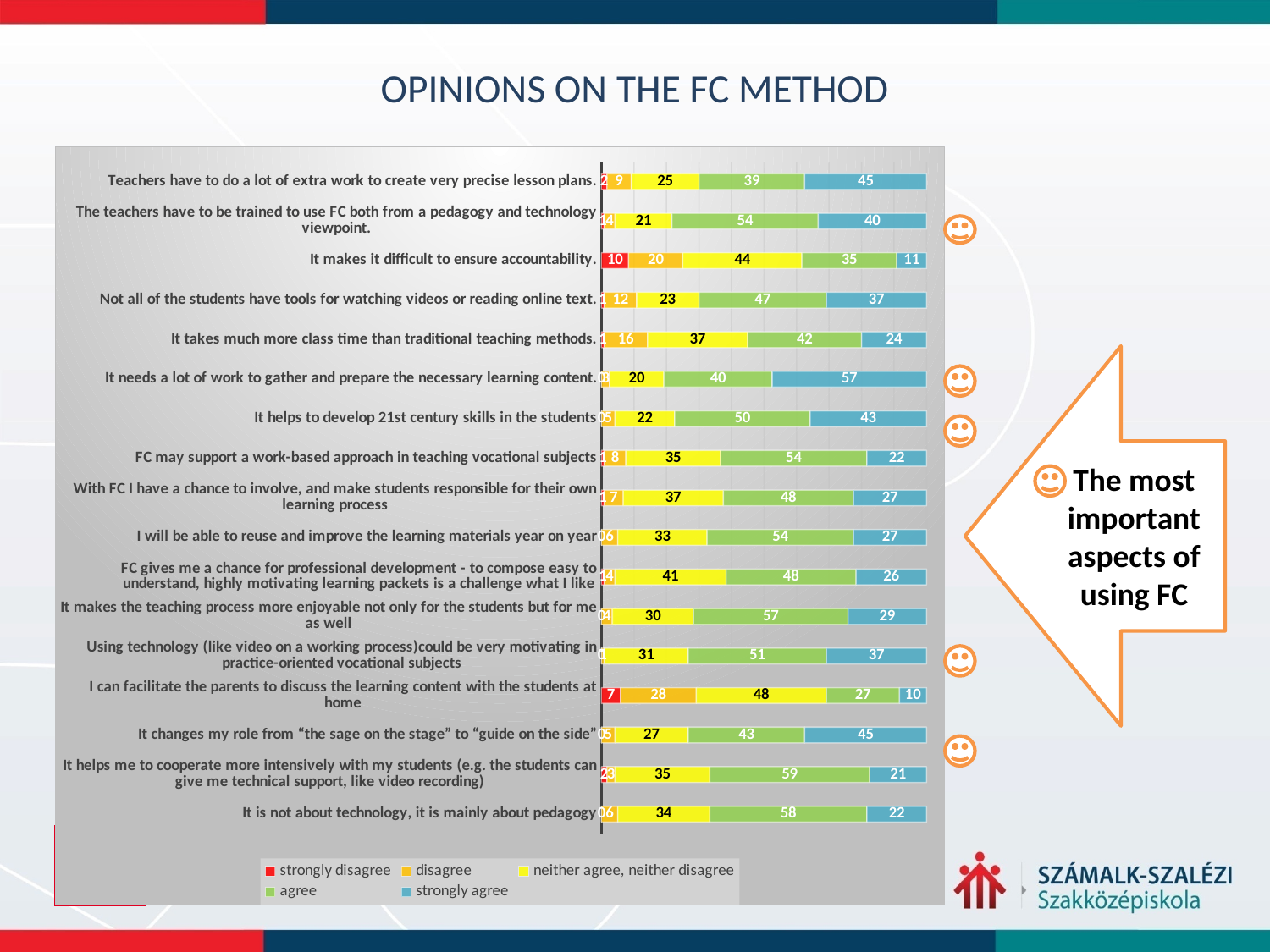
What is the total of the stacked bar for 'It makes it difficult to ensure accountability'? 120 What is the 'neither agree, neither disagree' value for 'It makes it difficult to ensure accountability'? 44 For 'Teachers have to do a lot of extra work to create very precise lesson plans', what is the difference between the 'strongly agree' and 'agree' values? 6 For 'It takes much more class time than traditional teaching methods', which is larger: the 'agree' value or the 'neither agree, neither disagree' value? agree What kind of chart is shown on the slide? Stacked bar chart What is the 'agree' value for 'It helps me to cooperate more intensively with my students (e.g. the students can give me technical support, like video recording)'? 59 How many statements (categories) are plotted in the chart? 17 Which statement has the lowest 'strongly agree' value? I can facilitate the parents to discuss the learning content with the students at home Which statement has the highest 'strongly agree' value? It needs a lot of work to gather and prepare the necessary learning content What is the 'strongly agree' value for 'It needs a lot of work to gather and prepare the necessary learning content'? 57 What is the 'strongly disagree' value for 'I can facilitate the parents to discuss the learning content with the students at home'? 7 How many series does the legend list? 5